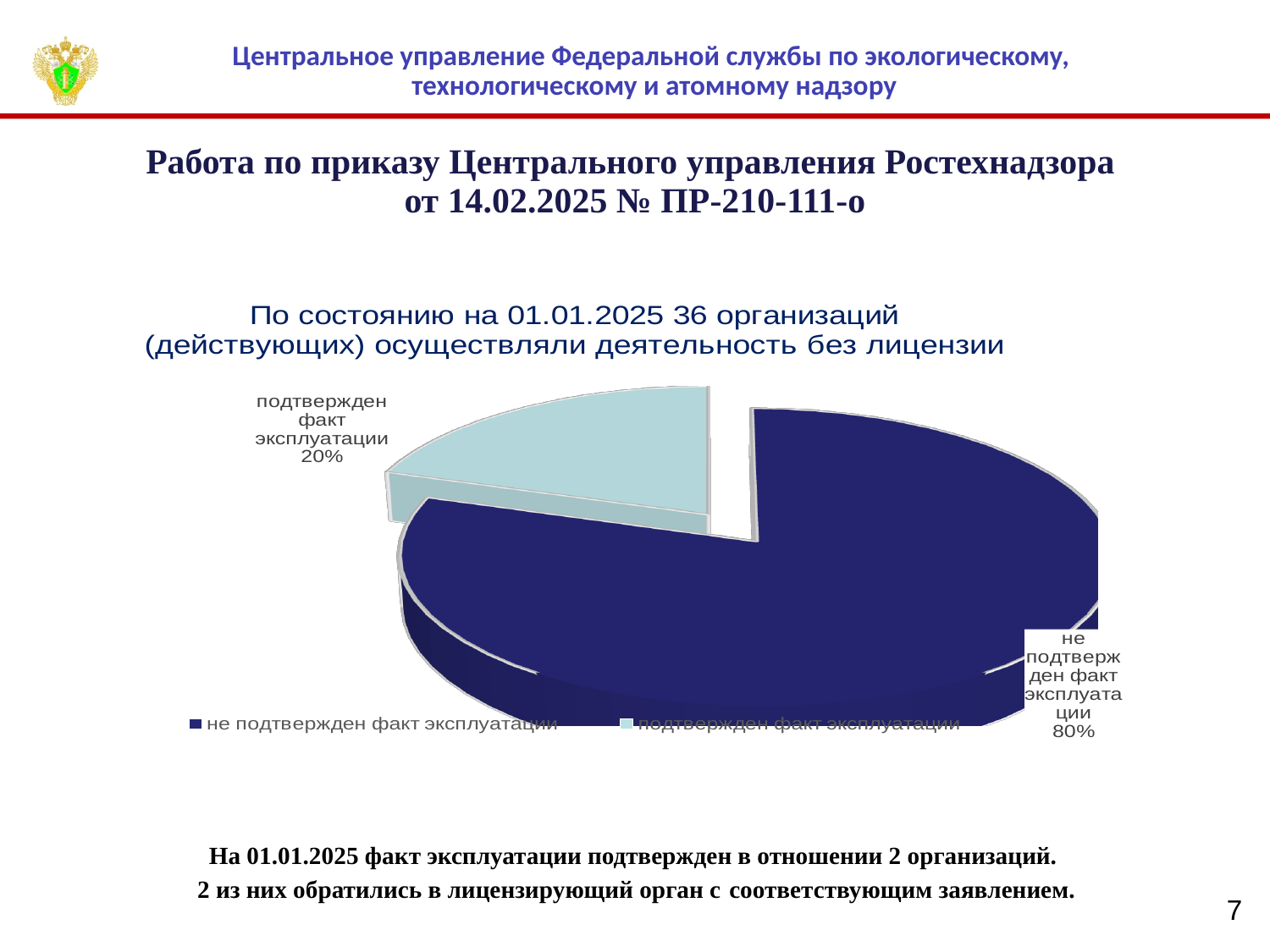
What share of the pie does the slice "не подтвержден факт эксплуатации" represent? 80% Which slice of the pie chart is the largest? не подтвержден факт эксплуатации How many entries does the chart legend list? 2 What is the difference in percentage points between the "не подтвержден факт эксплуатации" slice and the "подтвержден факт эксплуатации" slice? 60 percentage points Which is larger: the "подтвержден факт эксплуатации" slice or the "не подтвержден факт эксплуатации" slice? не подтвержден факт эксплуатации How many slices does the pie chart have? 2 What share of the pie does the slice "подтвержден факт эксплуатации" represent? 20% What colour is the "подтвержден факт эксплуатации" slice in the pie chart? light blue What is the title of the pie chart? По состоянию на 01.01.2025 36 организаций (действующих) осуществляли деятельность без лицензии Which slice of the pie chart is the smallest? подтвержден факт эксплуатации What kind of chart is shown on the slide? pie chart